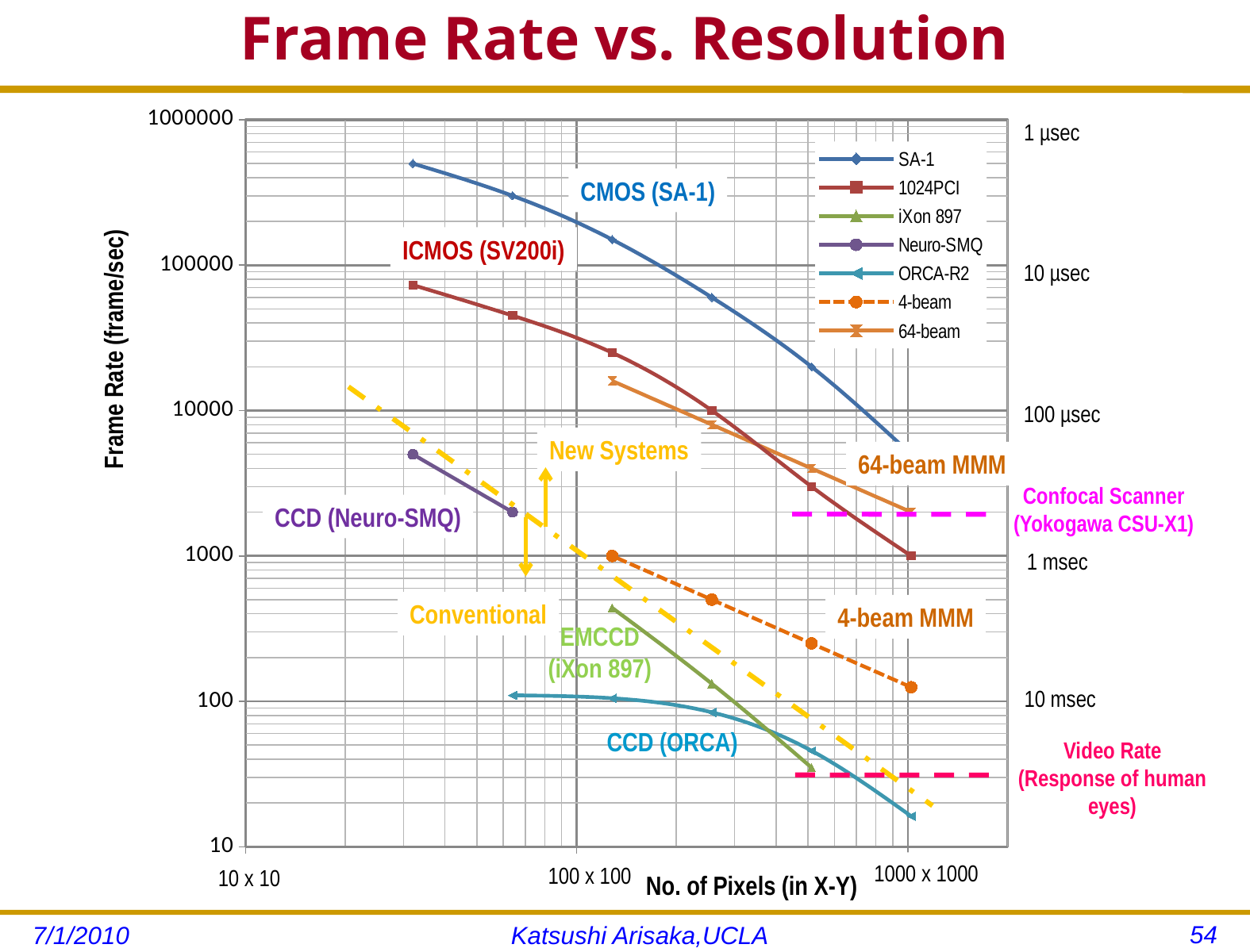
What kind of chart is shown on the slide? line chart How many series does the legend list? 7 What is the title of the chart? Frame Rate vs. Resolution Which series reaches the highest frame rate on the chart? SA-1 Is the frame rate of SA-1 at 1000 x 1000 pixels greater or less than 1000? greater Is the frame rate of 1024PCI at 100 x 100 pixels greater or less than 10000? greater Is the frame rate of ORCA-R2 at 1000 x 1000 pixels greater or less than 100? less Which series reaches the lowest frame rate on the chart? ORCA-R2 What is the label of the y axis? Frame Rate (frame/sec) At 100 x 100 pixels, which series has the higher frame rate, SA-1 or 1024PCI? SA-1 Does the frame rate of SA-1 rise or fall as the number of pixels increases? fall At 1000 x 1000 pixels, which series has the higher frame rate, 64-beam or 4-beam? 64-beam